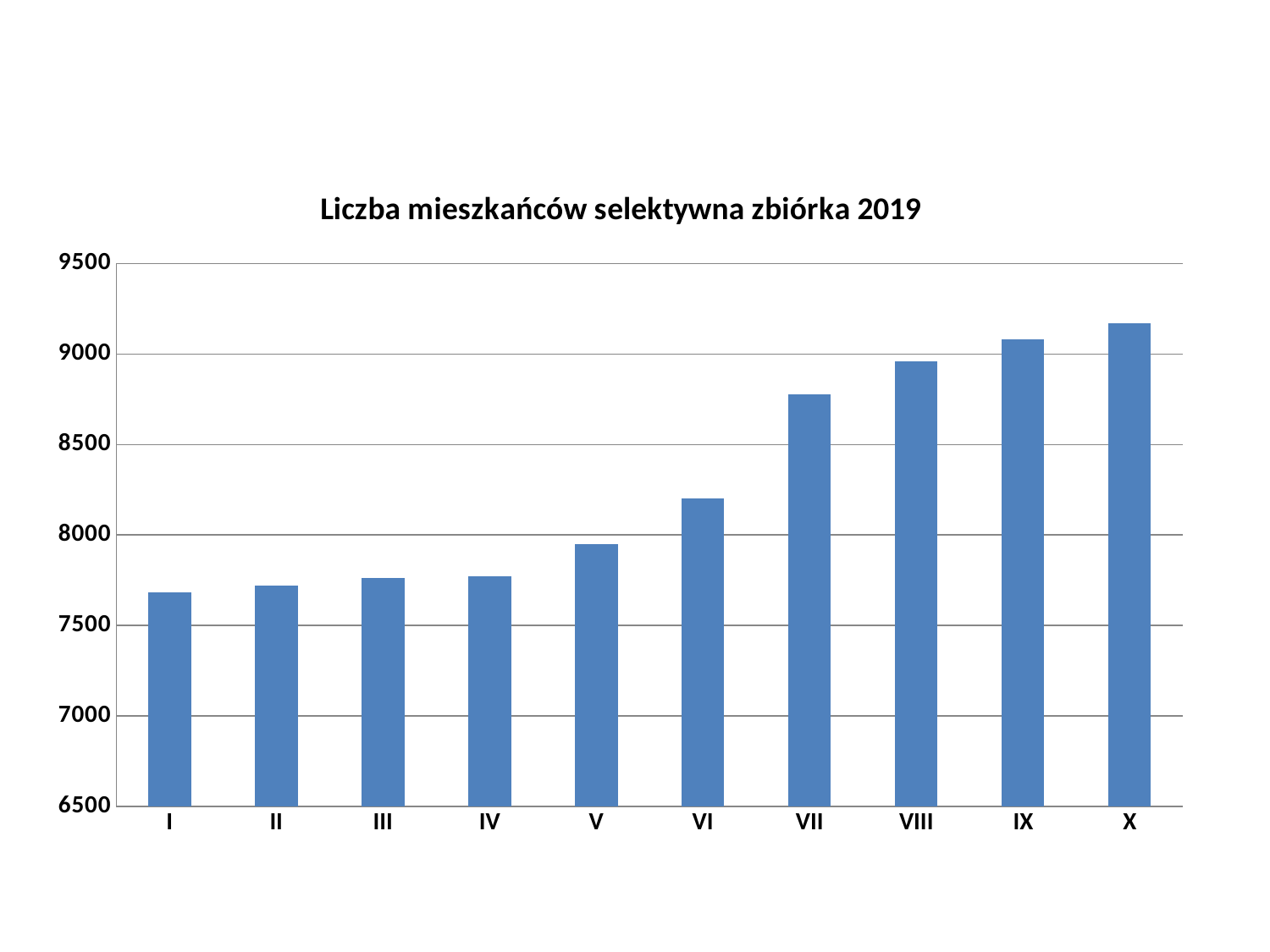
How many categories are shown on the x axis? 10 Is the value for X greater or less than 9000? greater Which is larger, the value for VII or the value for VI? VII Is the value for I greater or less than 8000? less What type of chart is shown on the slide? bar chart Which is larger, the value for II or the value for IX? IX Which category has the highest value? X Which category has the lowest value? I Do the values generally rise or fall from I to X? rise Is the value for VI greater or less than 8000? greater What is the title of the chart? Liczba mieszkańców selektywna zbiórka 2019